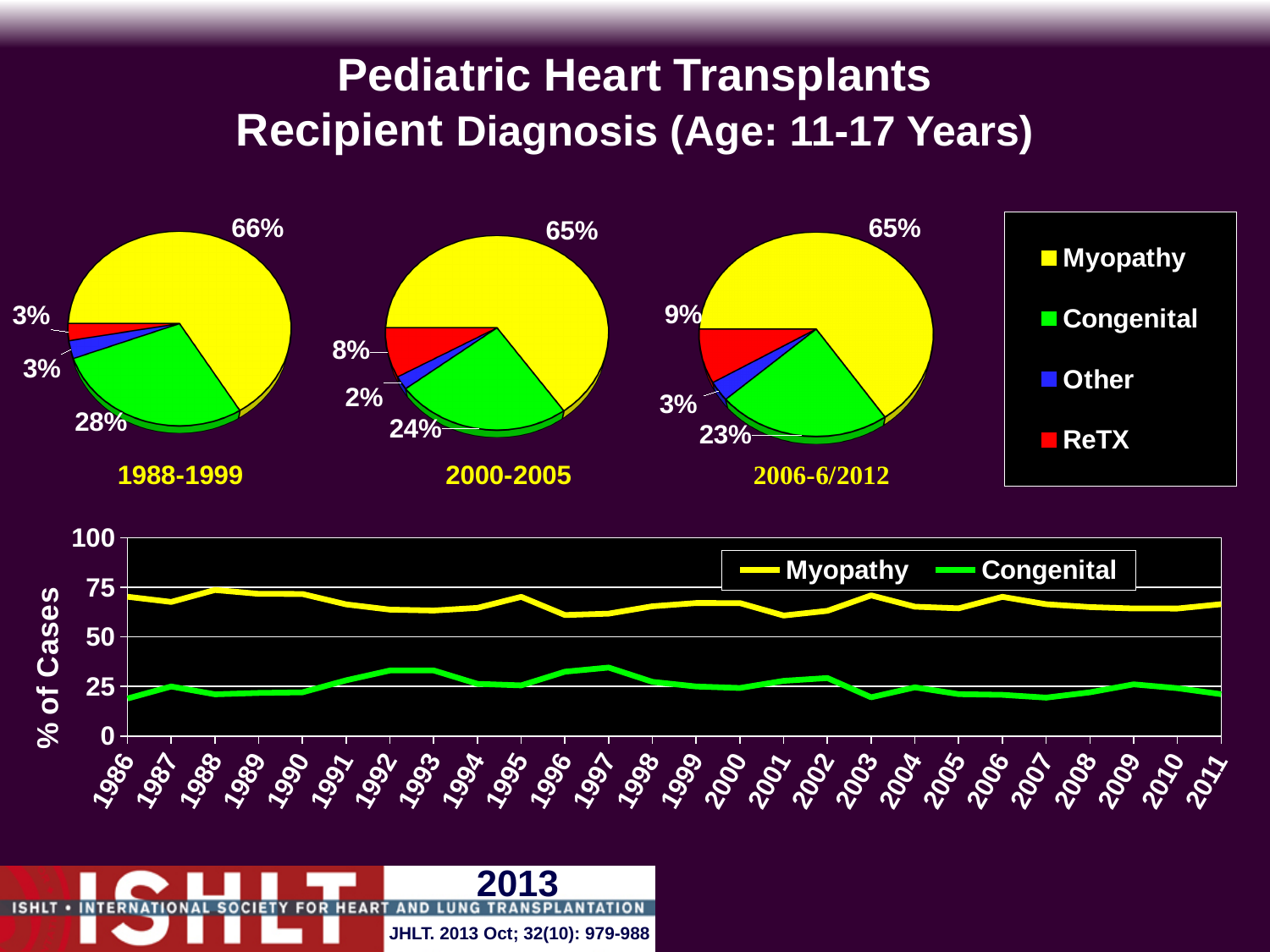
In the bottom line chart, is the Congenital value for 2003 greater or less than 25? less What kind of chart is the bottom chart on the slide? Line chart In the bottom line chart, is the Myopathy value for 1988 greater or less than 50? greater Comparing the pie charts, is the ReTX share larger in 2000-2005 or in 2006-6/2012? 2006-6/2012 In the 2006-6/2012 pie chart, what share of cases is Congenital? 23% In the 1988-1999 pie chart, what share of cases is Myopathy? 66% In the 2006-6/2012 pie chart, which diagnosis has the largest share? Myopathy In the 1988-1999 pie chart, what is the difference between the Myopathy share and the Congenital share? 38% How many pie charts are shown on the slide? 3 How many series does the legend of the bottom line chart list? 2 In the 2000-2005 pie chart, which diagnosis has the smallest share? Other In the 2000-2005 pie chart, what share of cases is ReTX? 8%